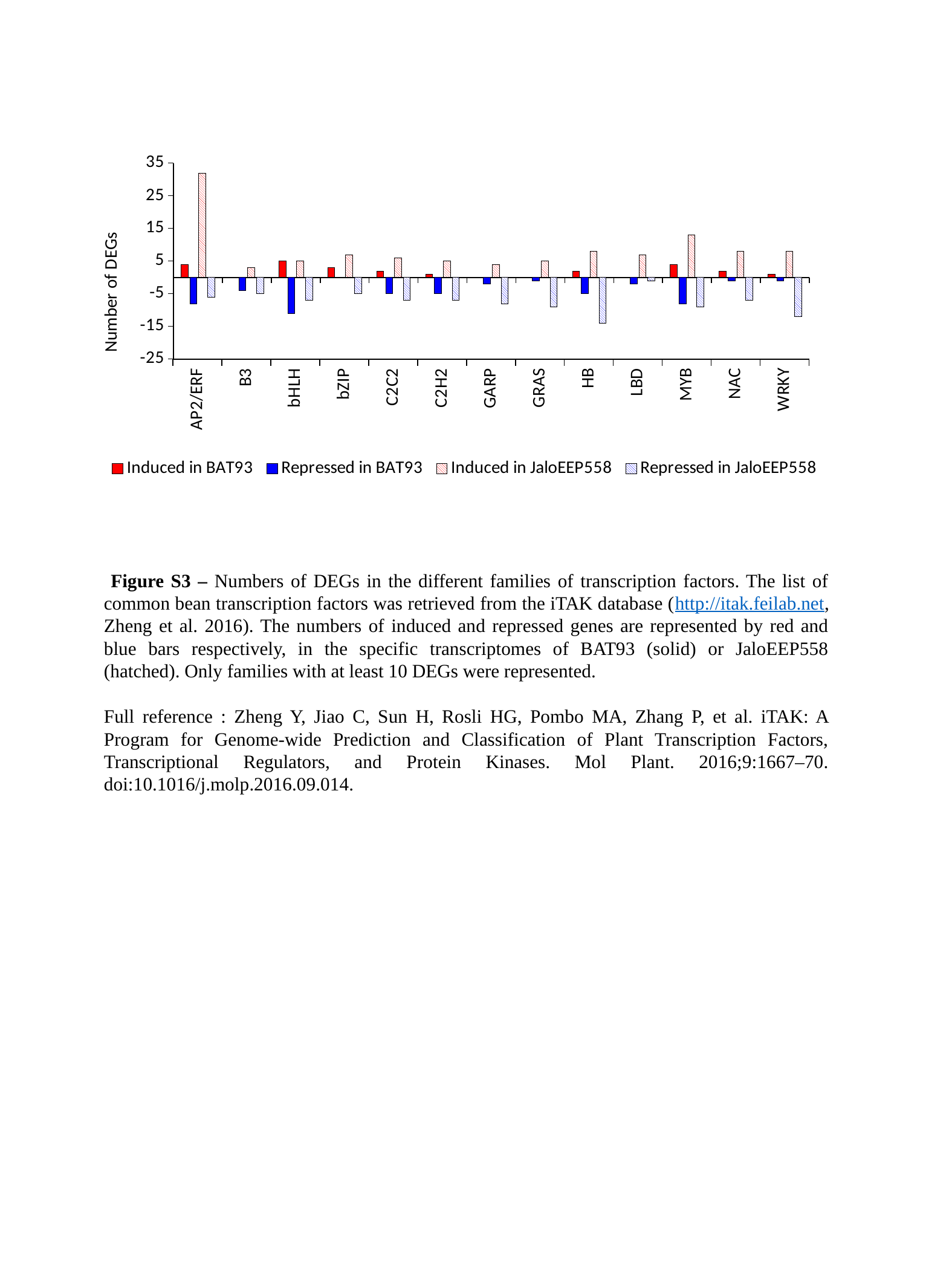
How many series does the legend list? 4 What is the y-axis title of the chart? Number of DEGs Which is larger for Induced in BAT93: bHLH or C2H2? bHLH Is the value for Induced in JaloEEP558 for AP2/ERF greater or less than 25? greater Which series is shown with solid red bars? Induced in BAT93 What kind of chart is shown on the slide? bar chart Which family has the highest value for Induced in JaloEEP558? AP2/ERF Which is larger for Induced in JaloEEP558: AP2/ERF or MYB? AP2/ERF Is the value for Induced in JaloEEP558 for MYB greater or less than 5? greater Is the value for Repressed in BAT93 for bHLH greater or less than -5? less How many transcription factor families are shown on the x axis? 13